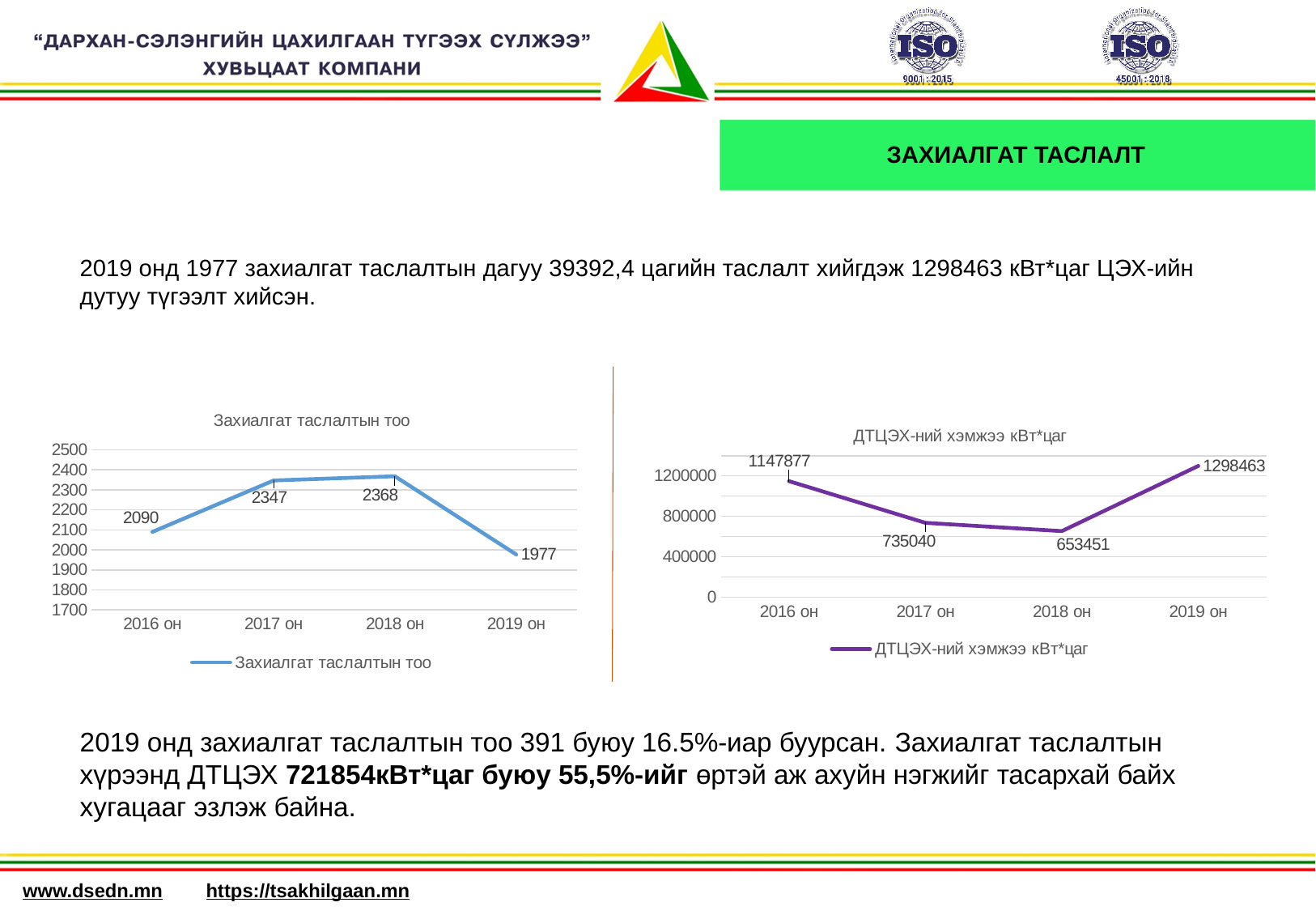
In the chart titled 'ДТЦЭХ-ний хэмжээ кВт*цаг', what is the value for 2016 он? 1147877 In the chart titled 'Захиалгат таслалтын тоо', what is the difference between the values for 2018 он and 2019 он? 391 In the chart titled 'ДТЦЭХ-ний хэмжээ кВт*цаг', which is larger, the value for 2017 он or 2018 он? 2017 он In the chart titled 'Захиалгат таслалтын тоо', how many data points are plotted? 4 In the chart titled 'Захиалгат таслалтын тоо', which year has the lowest value? 2019 он In the chart titled 'ДТЦЭХ-ний хэмжээ кВт*цаг', what is the value for 2018 он? 653451 In the chart titled 'ДТЦЭХ-ний хэмжээ кВт*цаг', which year has the highest value? 2019 он In the chart titled 'ДТЦЭХ-ний хэмжээ кВт*цаг', how many series does the legend list? 1 In the chart titled 'ДТЦЭХ-ний хэмжээ кВт*цаг', what is the difference between the values for 2019 он and 2016 он? 150586 What type of chart is the chart titled 'Захиалгат таслалтын тоо'? Line chart In the chart titled 'Захиалгат таслалтын тоо', which year has the highest value? 2018 он In the chart titled 'Захиалгат таслалтын тоо', what is the value for 2017 он? 2347